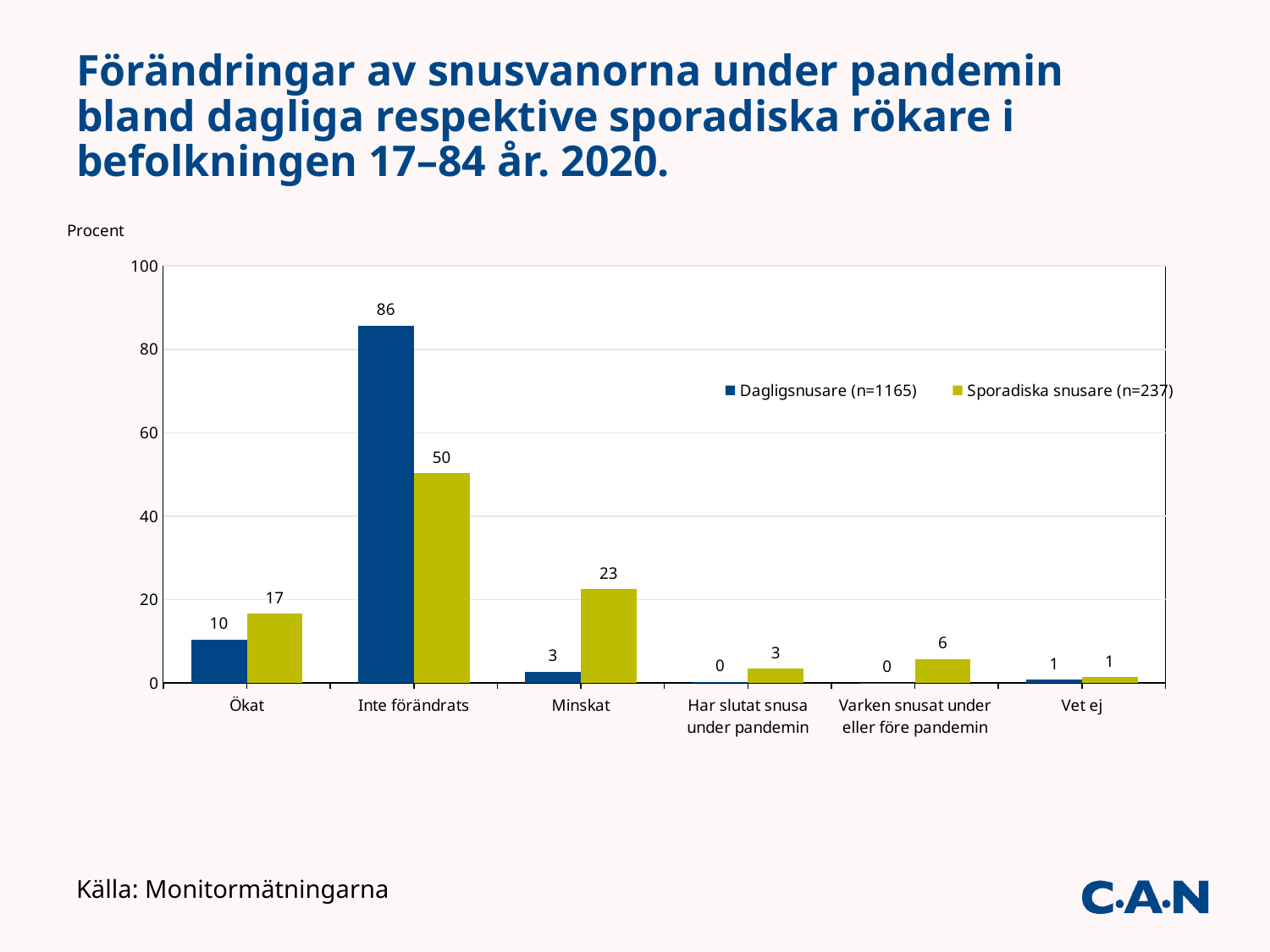
How many series does the legend list? 2 What is the difference between the Dagligsnusare (n=1165) and Sporadiska snusare (n=237) values in the Inte förändrats category? 36 What is the value for Sporadiska snusare (n=237) in the Ökat category? 17 Is the value for Dagligsnusare (n=1165) in the Inte förändrats category greater or less than 80? greater Which series has the larger value in the Minskat category, Dagligsnusare (n=1165) or Sporadiska snusare (n=237)? Sporadiska snusare (n=237) What is the label of the vertical axis? Procent How many categories are shown on the x axis? 6 What is the value for Dagligsnusare (n=1165) in the Inte förändrats category? 86 What kind of chart is shown on the slide? bar chart Which category has the lowest value for Sporadiska snusare (n=237)? Vet ej What is the value for Sporadiska snusare (n=237) in the Minskat category? 23 Which category has the highest value for Dagligsnusare (n=1165)? Inte förändrats